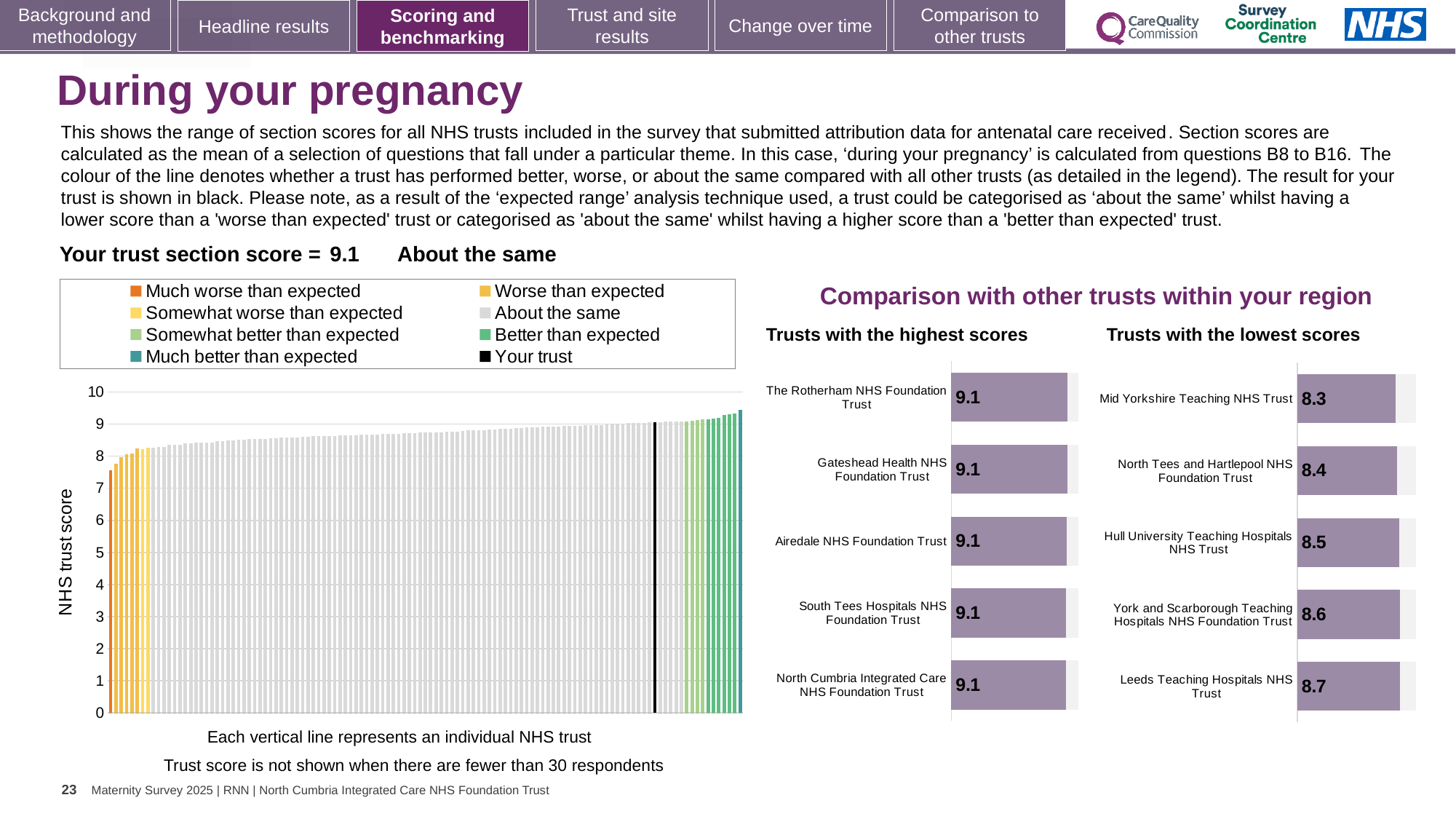
In the 'Trusts with the lowest scores' chart, what is the score for Mid Yorkshire Teaching NHS Trust? 8.3 In the 'Trusts with the lowest scores' chart, which trust has the lowest score? Mid Yorkshire Teaching NHS Trust In the 'Trusts with the lowest scores' chart, which trust has the highest score? Leeds Teaching Hospitals NHS Trust In the 'Trusts with the lowest scores' chart, what is the difference between the scores of Leeds Teaching Hospitals NHS Trust and Mid Yorkshire Teaching NHS Trust? 0.4 In the 'Trusts with the highest scores' chart, what is the score for Airedale NHS Foundation Trust? 9.1 What kind of chart is the 'Trusts with the highest scores' chart? Bar chart In the 'Trusts with the lowest scores' chart, which has the larger score: North Tees and Hartlepool NHS Foundation Trust or York and Scarborough Teaching Hospitals NHS Foundation Trust? York and Scarborough Teaching Hospitals NHS Foundation Trust In the large chart on the left, is the value of the lowest (leftmost) bar greater or less than 8? less How many entries does the legend of the large chart on the left list? 8 In the 'Trusts with the lowest scores' chart, what is the score for Hull University Teaching Hospitals NHS Trust? 8.5 What is the y-axis label of the large chart on the left? NHS trust score How many trusts are listed in the 'Trusts with the highest scores' chart? 5